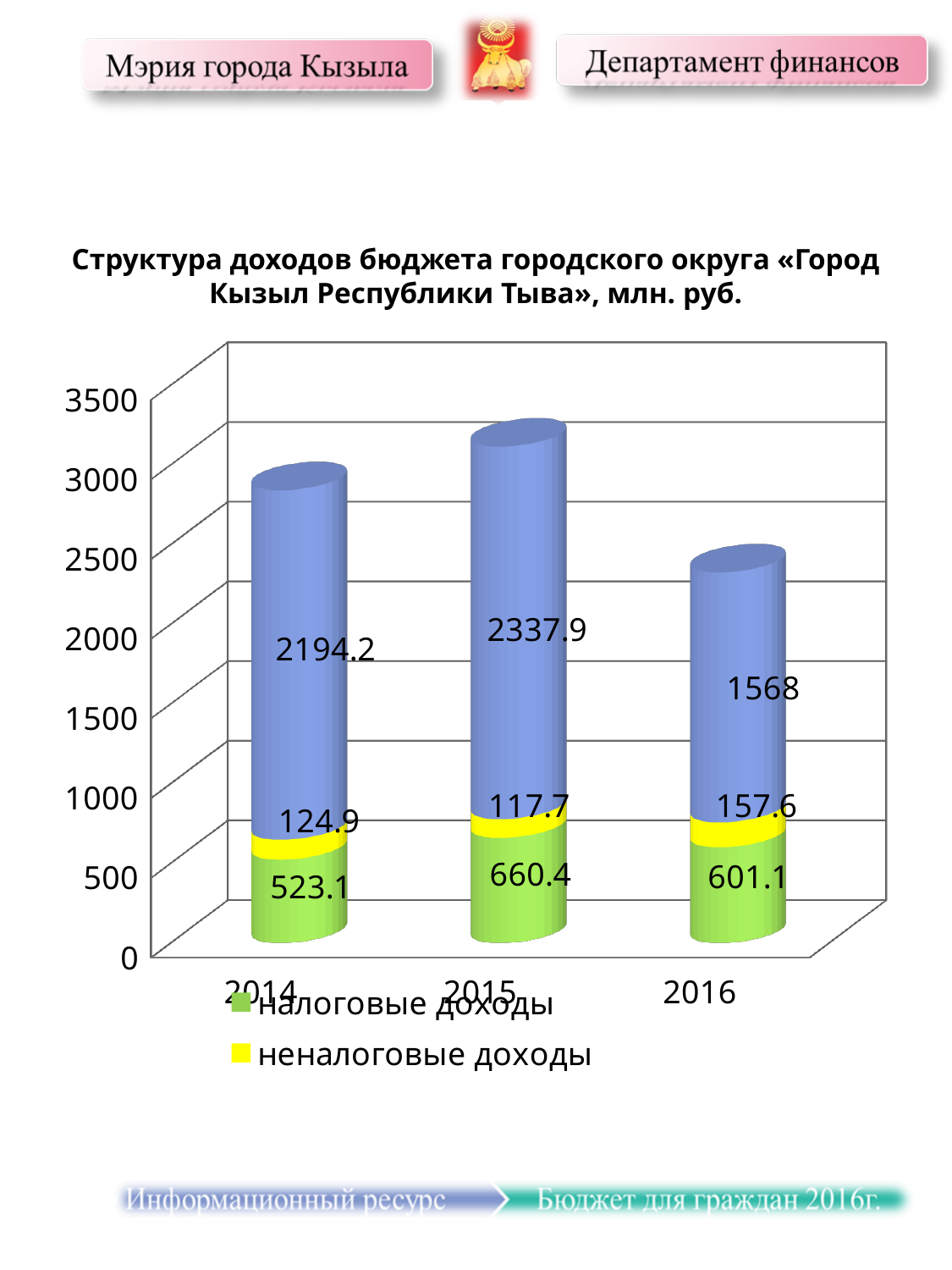
Which is larger: неналоговые доходы in 2014 or in 2016? 2016 What kind of chart is shown on the slide? Stacked bar chart What is the value of налоговые доходы for 2014? 523.1 What is the total of the stacked bar for 2016? 2326.7 What is the total of the stacked bar for 2014? 2842.2 How many years are shown on the x axis? 3 What is the value of налоговые доходы for 2015? 660.4 What is the difference between налоговые доходы in 2015 and 2014? 137.3 What colour represents неналоговые доходы in the chart? Yellow Which year has the highest value of налоговые доходы? 2015 Which year has the lowest value of неналоговые доходы? 2015 What is the value of неналоговые доходы for 2016? 157.6